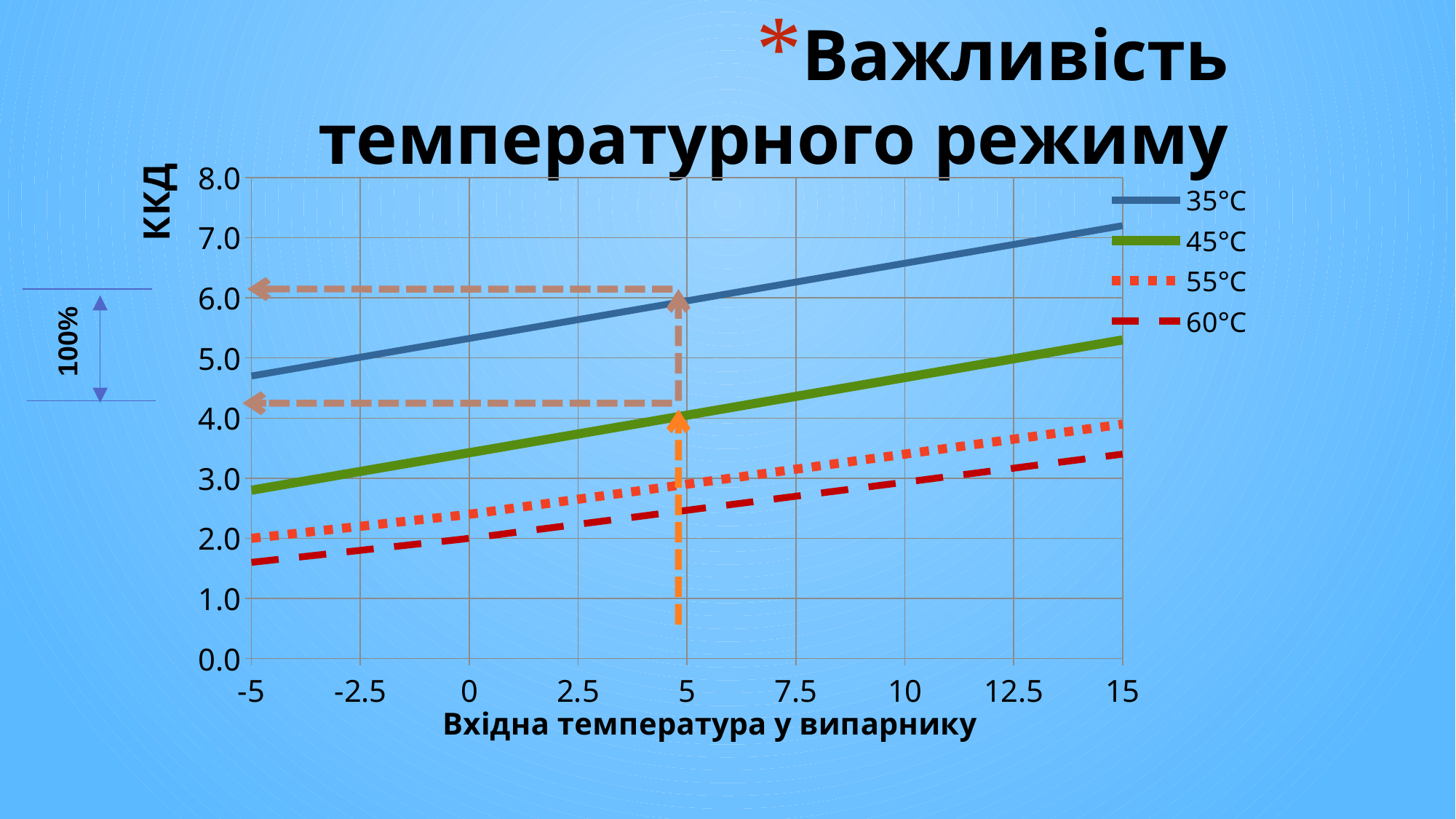
Is the ККД value for the 35°C series at an input temperature of 15 greater or less than 6.0? greater Which series has the lowest ККД at an input temperature of -5? 60°C At an input temperature of 5, which series has the larger ККД: 35°C or 55°C? 35°C Do the ККД values rise or fall as the input temperature increases along the x axis? rise Is the ККД value for the 35°C series at an input temperature of -5 greater or less than 4.0? greater What kind of chart is shown on the slide? line chart How many series does the legend list? 4 Is the ККД value for the 60°C series at an input temperature of -5 greater or less than 2.0? less Which series has the highest ККД at an input temperature of 15? 35°C What is the title of the x axis? Вхідна температура у випарнику What is the label of the y axis? ККД